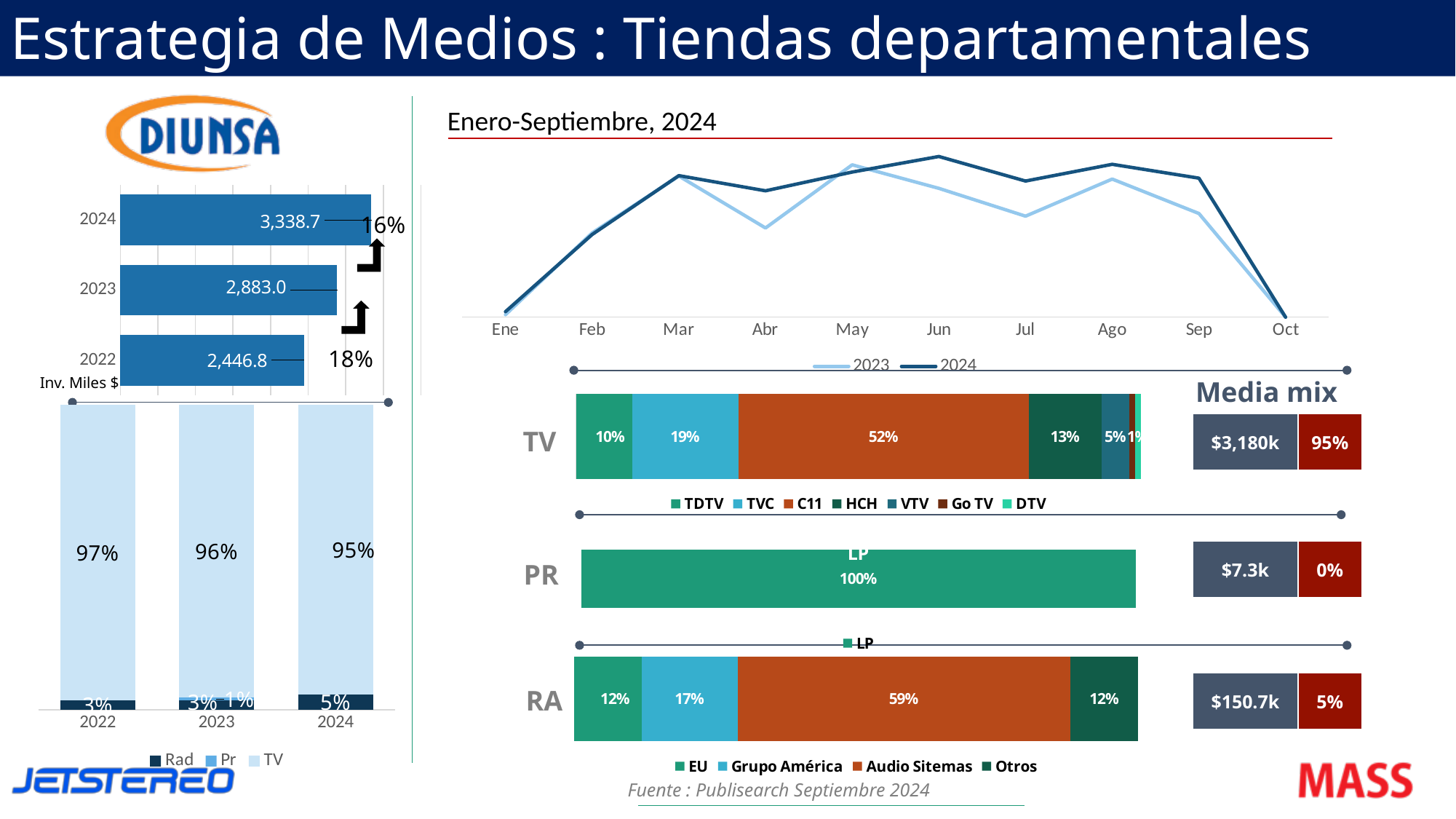
In the horizontal bar chart of investment by year on the left, what is the value for 2022? 2,446.8 In the horizontal bar chart of investment by year on the left, what is the difference between the 2024 and 2023 values? 455.7 In the Media mix boxes on the right, what is the amount shown for RA? $150.7k In the TV stacked bar on the right, what is the share for C11? 52% In the line chart titled Enero-Septiembre, 2024, how many months are shown on the x axis? 10 In the stacked bar chart of media share by year at the bottom left, how many series does the legend list? 3 In the RA stacked bar on the right, which channel has the largest share? Audio Sitemas In the stacked bar chart of media share by year at the bottom left, what is the TV share for 2023? 96% In the stacked bar chart of media share by year at the bottom left, what is the Rad share for 2024? 5% In the line chart titled Enero-Septiembre, 2024, which series is higher in Jun, 2023 or 2024? 2024 In the horizontal bar chart of investment by year (Inv. Miles $) on the left, what is the value for 2024? 3,338.7 In the horizontal bar chart of investment by year on the left, which year has the highest value? 2024